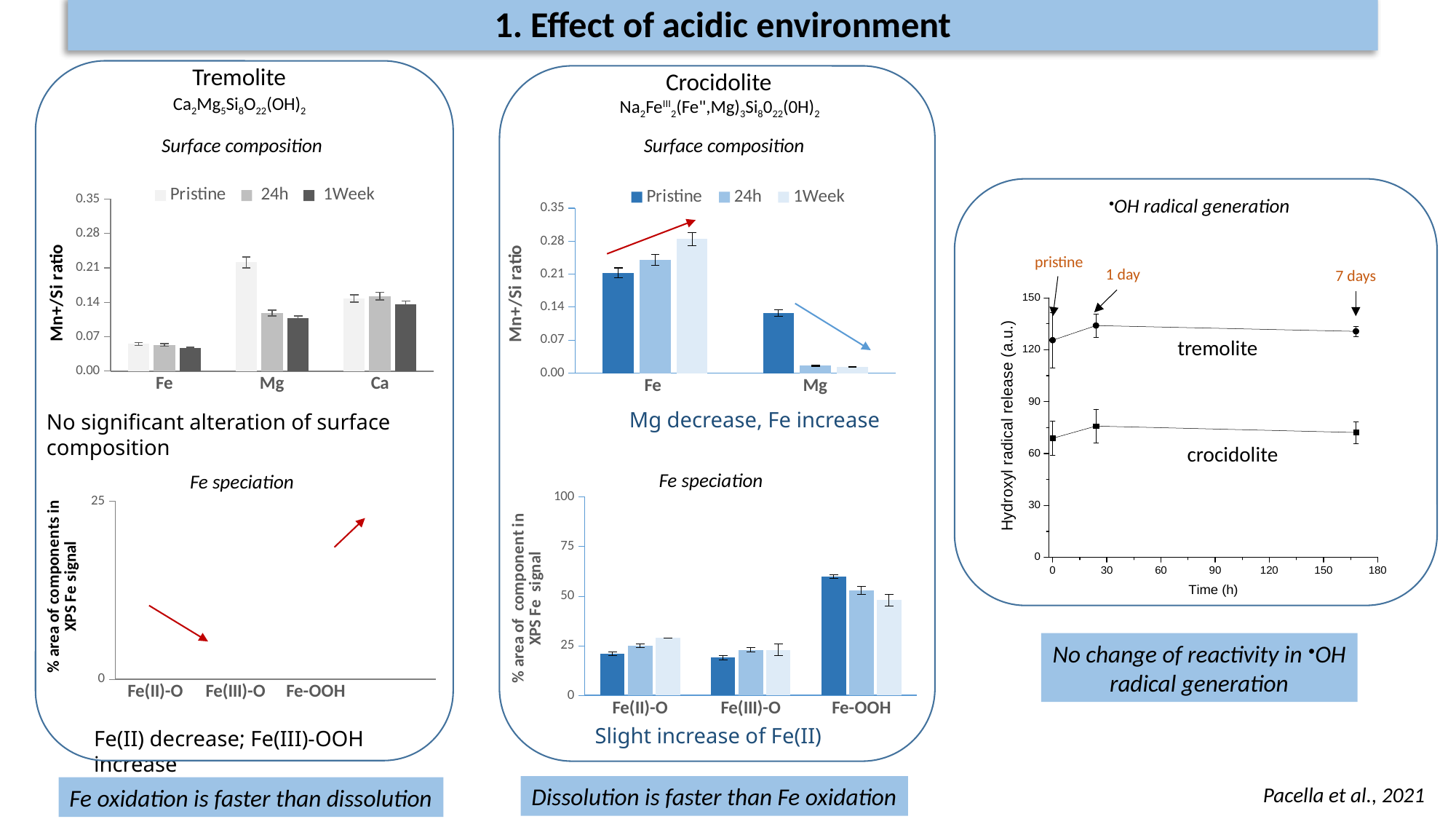
In the Crocidolite Fe speciation chart, is the Pristine value for Fe-OOH greater or less than 50? greater In the Tremolite Surface composition chart, is the Pristine value for Mg greater or less than 0.14? greater In the Crocidolite Fe speciation chart, which category has the highest bars? Fe-OOH In the Crocidolite Surface composition chart, do the Fe bars rise or fall from Pristine to 1Week? rise In the Crocidolite Surface composition chart, is the 1Week value for Fe greater or less than 0.21? greater In the Tremolite Surface composition chart, how many series does the legend list? 3 What kind of chart is the OH radical generation chart? line chart In the Tremolite Surface composition chart, which category has the highest Pristine bar? Mg In the OH radical generation chart, which series has higher hydroxyl radical release, tremolite or crocidolite? tremolite In the Crocidolite Surface composition chart, how many categories are shown on the x axis? 2